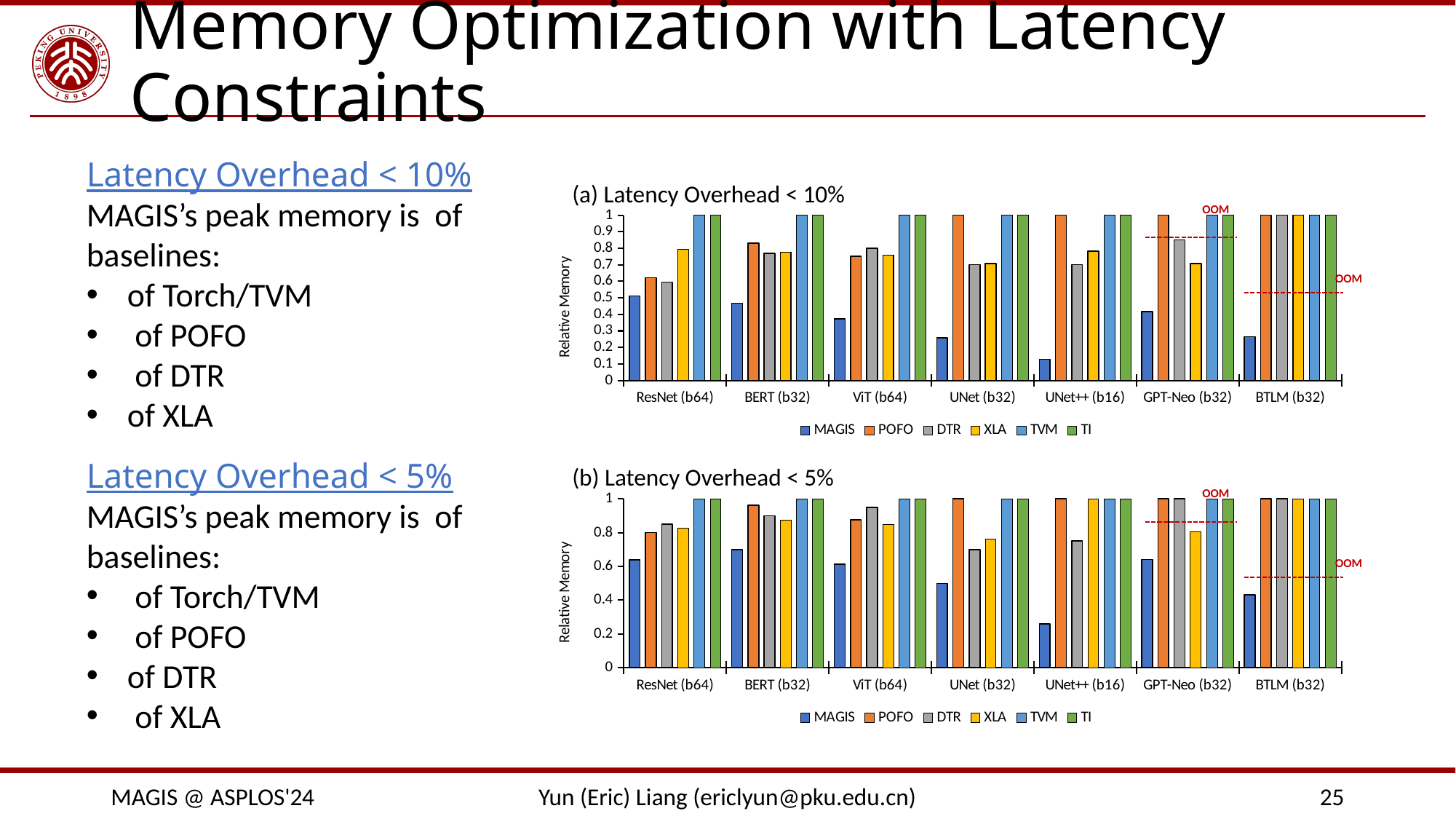
In chart (b) Latency Overhead < 5%, is the MAGIS value for UNet++ (b16) greater or less than 0.2? greater How many series does the legend of chart (a) Latency Overhead < 10% list? 6 In chart (a) Latency Overhead < 10%, for ResNet (b64), which is larger: the POFO bar or the XLA bar? XLA In chart (a) Latency Overhead < 10%, which model category has the lowest MAGIS bar? UNet++ (b16) In chart (a) Latency Overhead < 10%, is the MAGIS value for UNet++ (b16) greater or less than 0.2? less How many model categories are shown on the x axis of chart (b) Latency Overhead < 5%? 7 Which series is shown in orange in the legend of chart (a) Latency Overhead < 10%? POFO In chart (a) Latency Overhead < 10%, is the MAGIS value for UNet (b32) greater or less than 0.3? less What is the y-axis label of chart (b) Latency Overhead < 5%? Relative Memory What kind of chart is chart (a) Latency Overhead < 10%? bar chart In chart (b) Latency Overhead < 5%, which model category has the lowest MAGIS bar? UNet++ (b16) In chart (b) Latency Overhead < 5%, for ViT (b64), which is larger: the DTR bar or the XLA bar? DTR